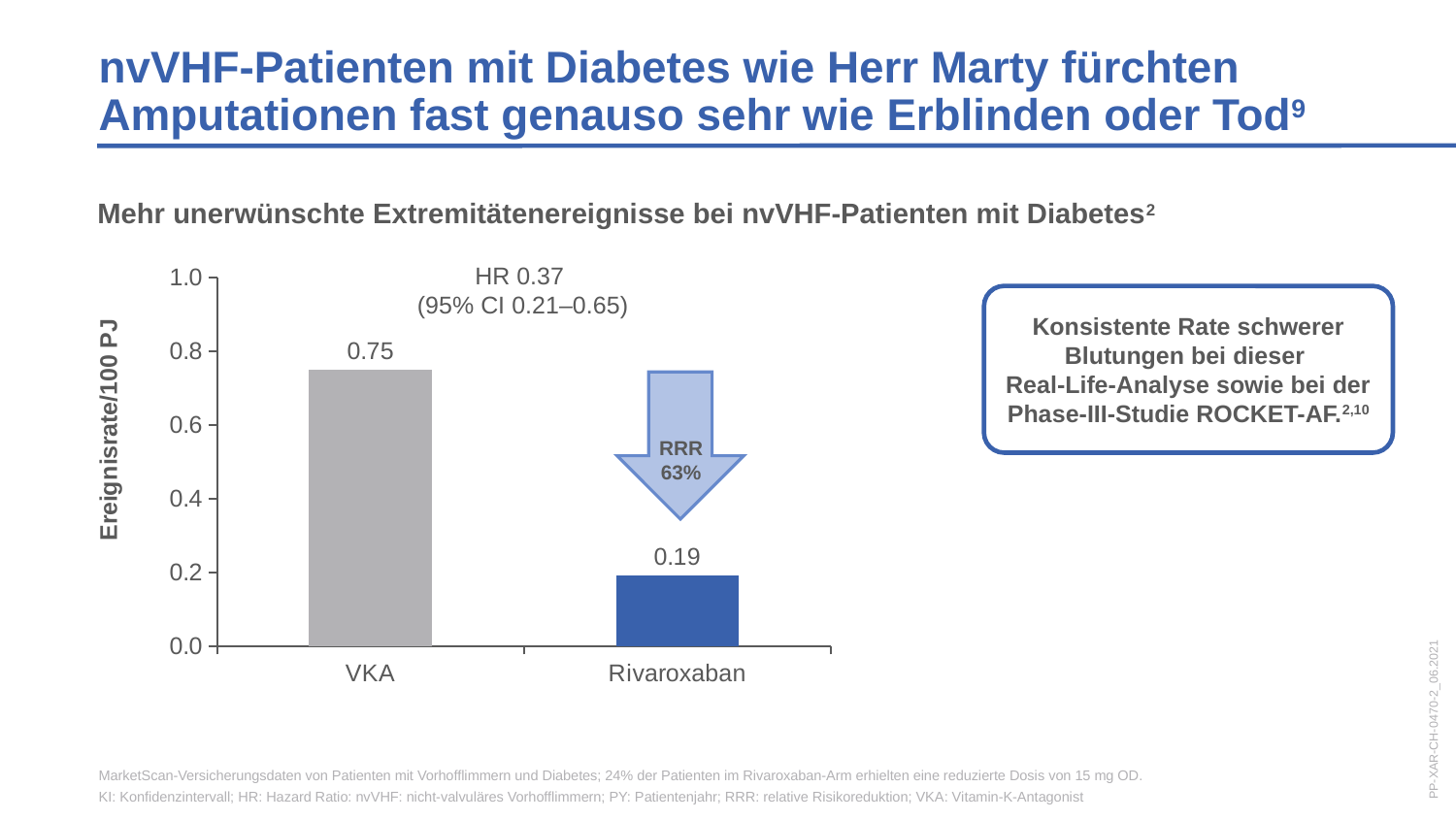
Which treatment has the higher event rate? VKA What is the label of the y axis? Ereignisrate/100 PJ What is the difference between the VKA and Rivaroxaban event rates? 0.56 What is the hazard ratio shown above the bars? 0.37 What is the event rate per 100 PJ for Rivaroxaban? 0.19 Is the event rate for Rivaroxaban greater or less than 0.4? less Is the event rate for VKA greater or less than 0.6? greater Which treatment has the lower event rate? Rivaroxaban How many treatment categories are shown on the x axis? 2 What kind of chart is shown on the slide? Bar chart What relative risk reduction (RRR) is shown in the arrow between the bars? 63% What is the event rate per 100 PJ for VKA? 0.75